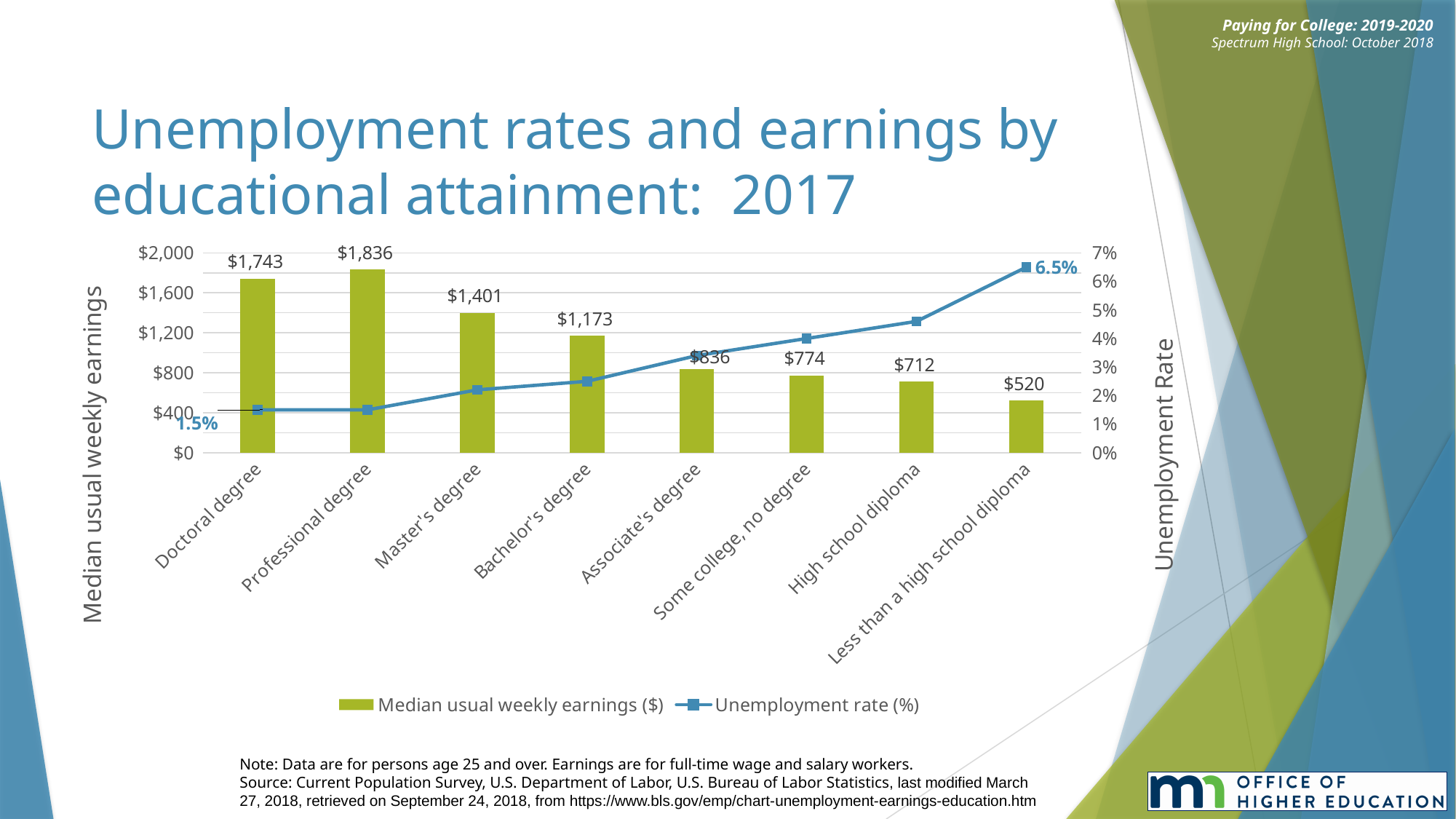
Which has higher median usual weekly earnings, an Associate's degree or Some college, no degree? Associate's degree What is the difference in median usual weekly earnings between a Master's degree and a High school diploma? $689 What is the median usual weekly earnings for a Bachelor's degree? $1,173 Which educational attainment level has the lowest median usual weekly earnings? Less than a high school diploma Which educational attainment level has the highest median usual weekly earnings? Professional degree What is the median usual weekly earnings for a Professional degree? $1,836 Is the unemployment rate for a Bachelor's degree greater or less than 3%? less How many series does the legend list? 2 How does the unemployment rate change moving from Doctoral degree to Less than a high school diploma along the x axis? It rises What is the unemployment rate for Less than a high school diploma? 6.5% How many educational attainment categories are shown on the x axis? 8 What is the label of the right-hand vertical axis? Unemployment Rate